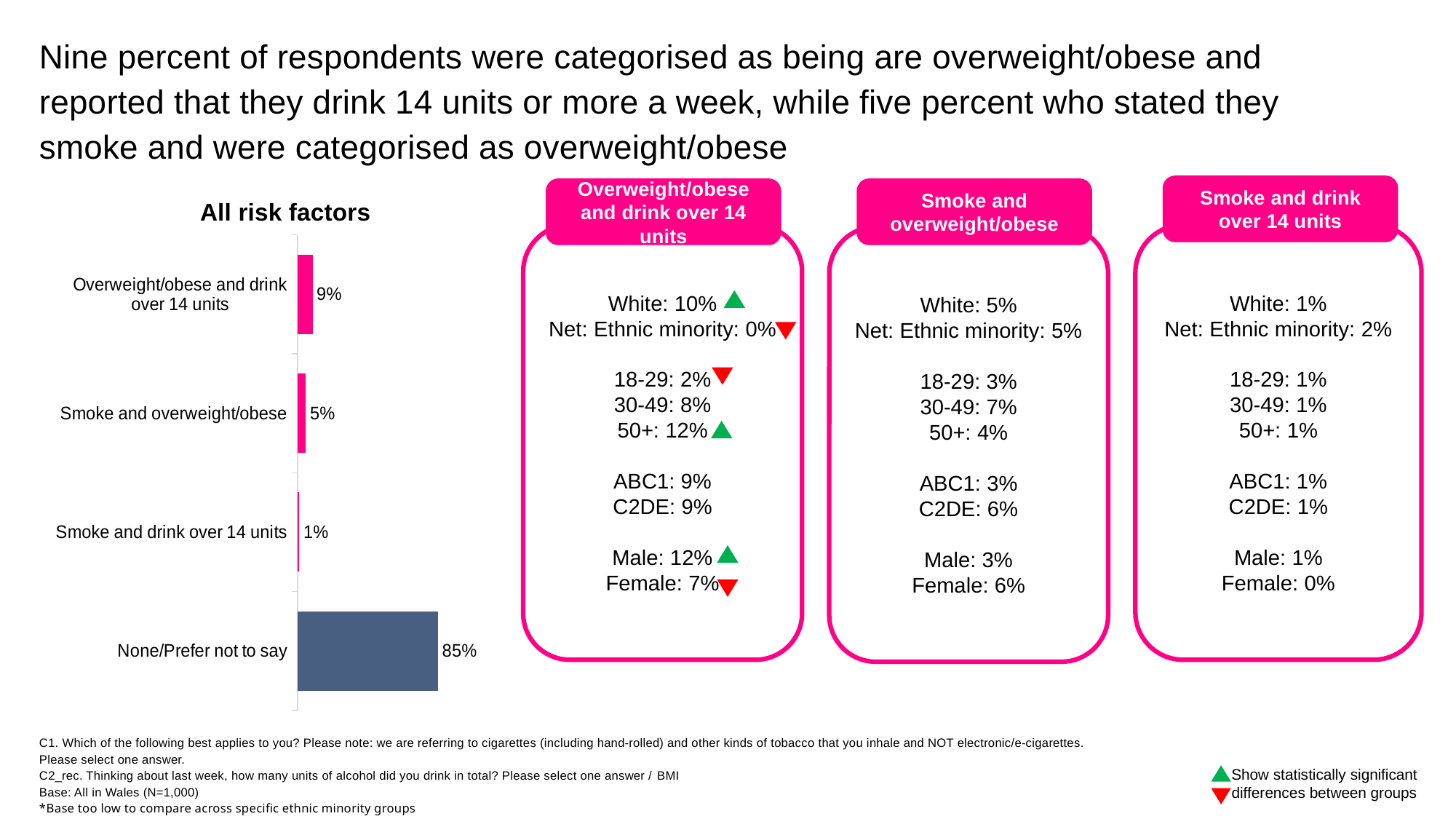
What is the value for 'Overweight/obese and drink over 14 units' in the 'All risk factors' chart? 9% Which category has the highest value in the 'All risk factors' chart? None/Prefer not to say What type of chart is the 'All risk factors' chart? Bar chart What is the value for 'Smoke and overweight/obese' in the 'All risk factors' chart? 5% What is the difference between 'Overweight/obese and drink over 14 units' and 'Smoke and overweight/obese' in the 'All risk factors' chart? 4% How many categories are shown in the 'All risk factors' chart? 4 What is the value for 'Smoke and drink over 14 units' in the 'All risk factors' chart? 1% What is the difference between 'None/Prefer not to say' and 'Overweight/obese and drink over 14 units' in the 'All risk factors' chart? 76% Which category has the lowest value in the 'All risk factors' chart? Smoke and drink over 14 units What is the title of the bar chart on the slide? All risk factors What is the value for 'None/Prefer not to say' in the 'All risk factors' chart? 85% Which is larger in the 'All risk factors' chart: 'Smoke and overweight/obese' or 'Smoke and drink over 14 units'? Smoke and overweight/obese